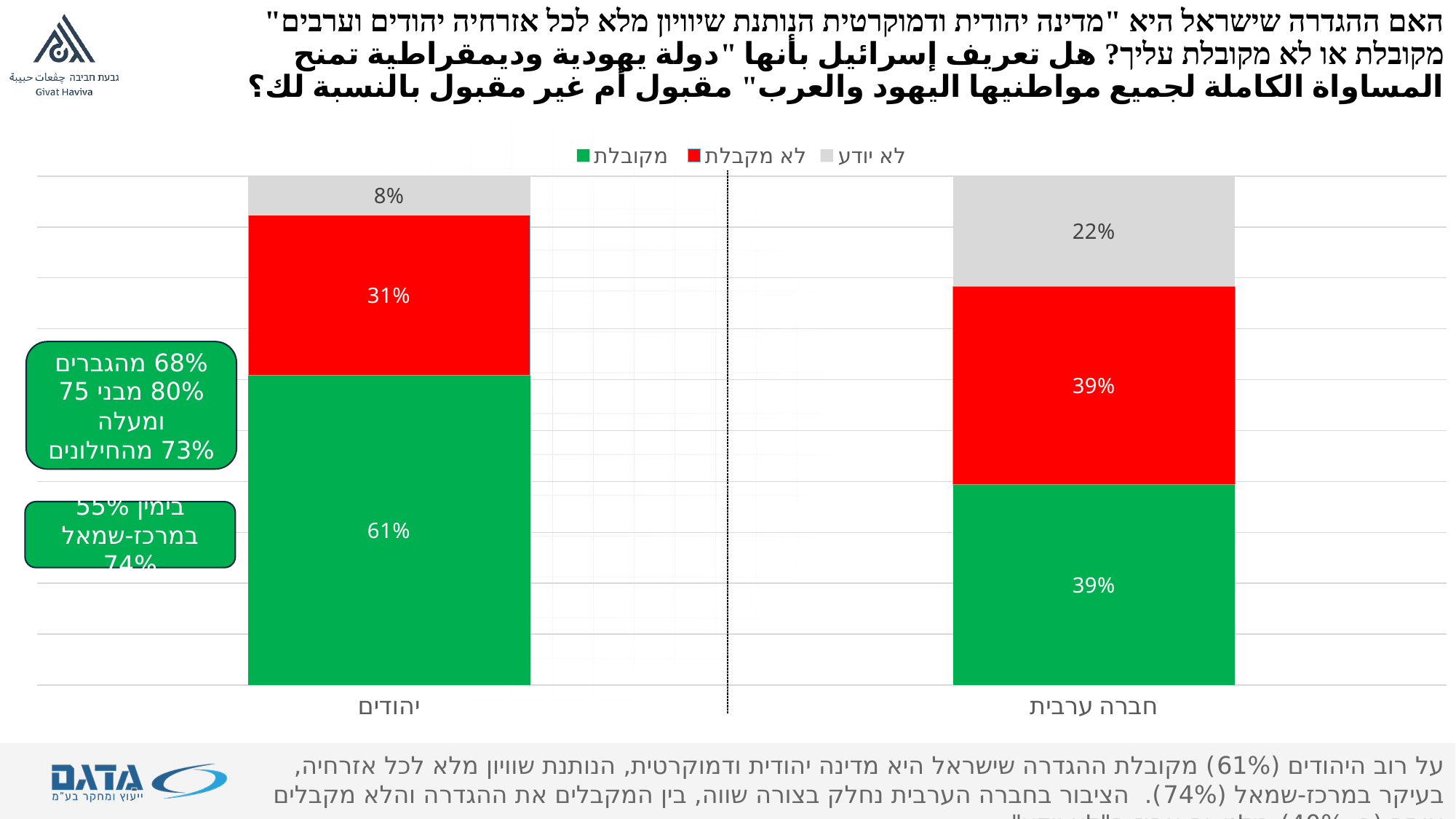
What percentage of חברה ערבית answered לא מקובלת? 39% What percentage of יהודים answered לא מקובלת? 31% Which group has the higher מקובלת share? יהודים How many series does the legend list? 3 Which colour represents the מקובלת series in the legend? Green What kind of chart is shown on the slide? Stacked bar chart What percentage of חברה ערבית answered לא יודע? 22% What is the difference between the מקובלת share for יהודים and for חברה ערבית? 22 percentage points How many groups (categories) are shown on the x axis? 2 Which group has the higher לא יודע share, יהודים or חברה ערבית? חברה ערבית Which response has the lowest share among יהודים? לא יודע What percentage of יהודים answered מקובלת? 61%